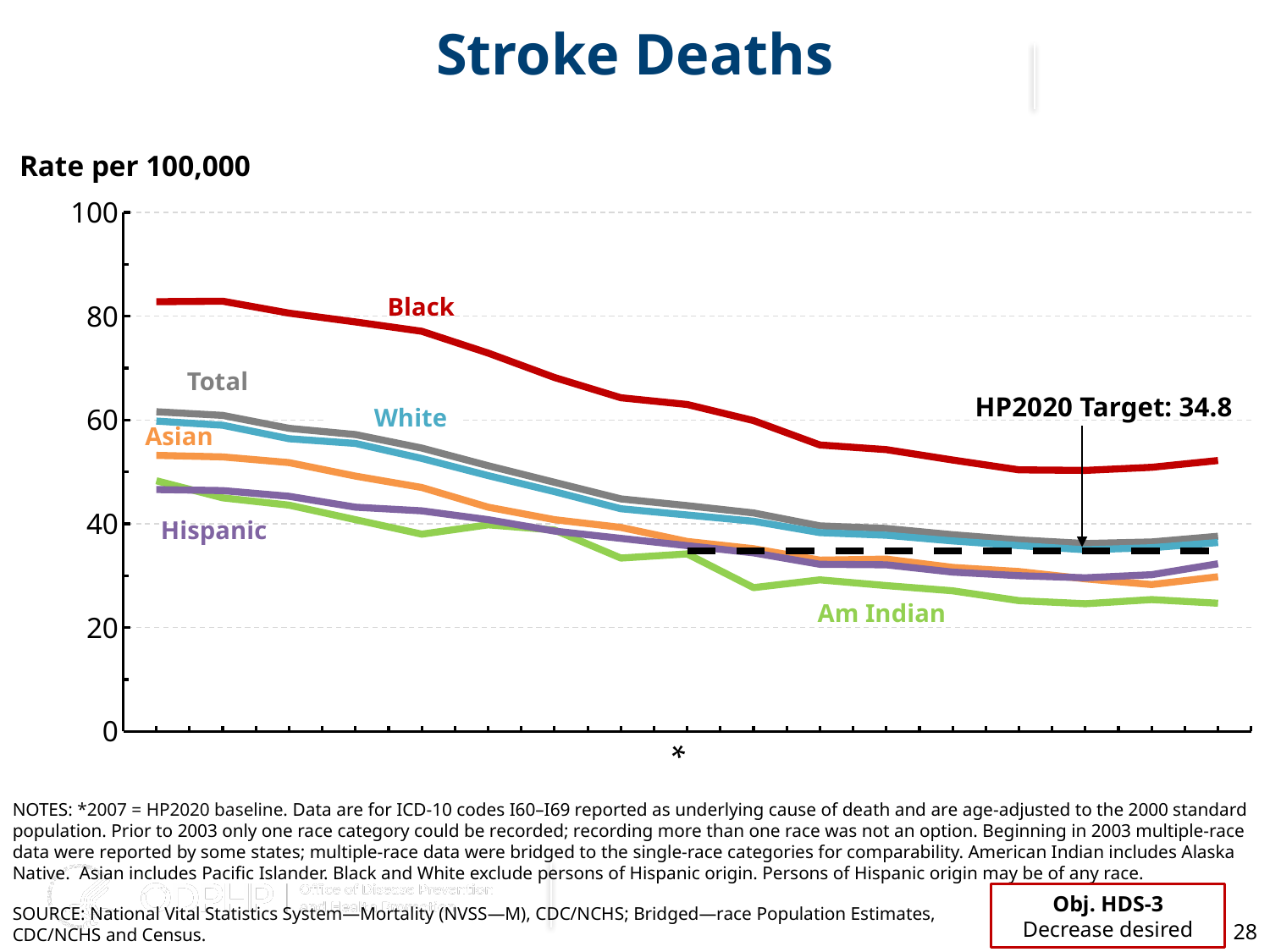
What is the maximum value shown on the y axis? 100 Is the value for Black at the start of the chart greater or less than 80? greater What is the HP2020 Target value shown on the chart? 34.8 Do the stroke death rates generally rise or fall from left to right along the x axis? fall At the start of the chart, which is larger, the Asian rate or the Hispanic rate? Asian At the end of the chart, which is larger, the Black rate or the Am Indian rate? Black Which group has the lowest stroke death rate at the right end of the chart? Am Indian How many population groups (lines) are labeled on the chart, not counting the target line? 6 What unit is the y axis measured in, according to the label above the chart? Rate per 100,000 What kind of chart is shown on the Stroke Deaths slide? line chart Is the value for Am Indian at the end of the chart greater or less than 30? less Which group has the highest stroke death rate throughout the chart? Black